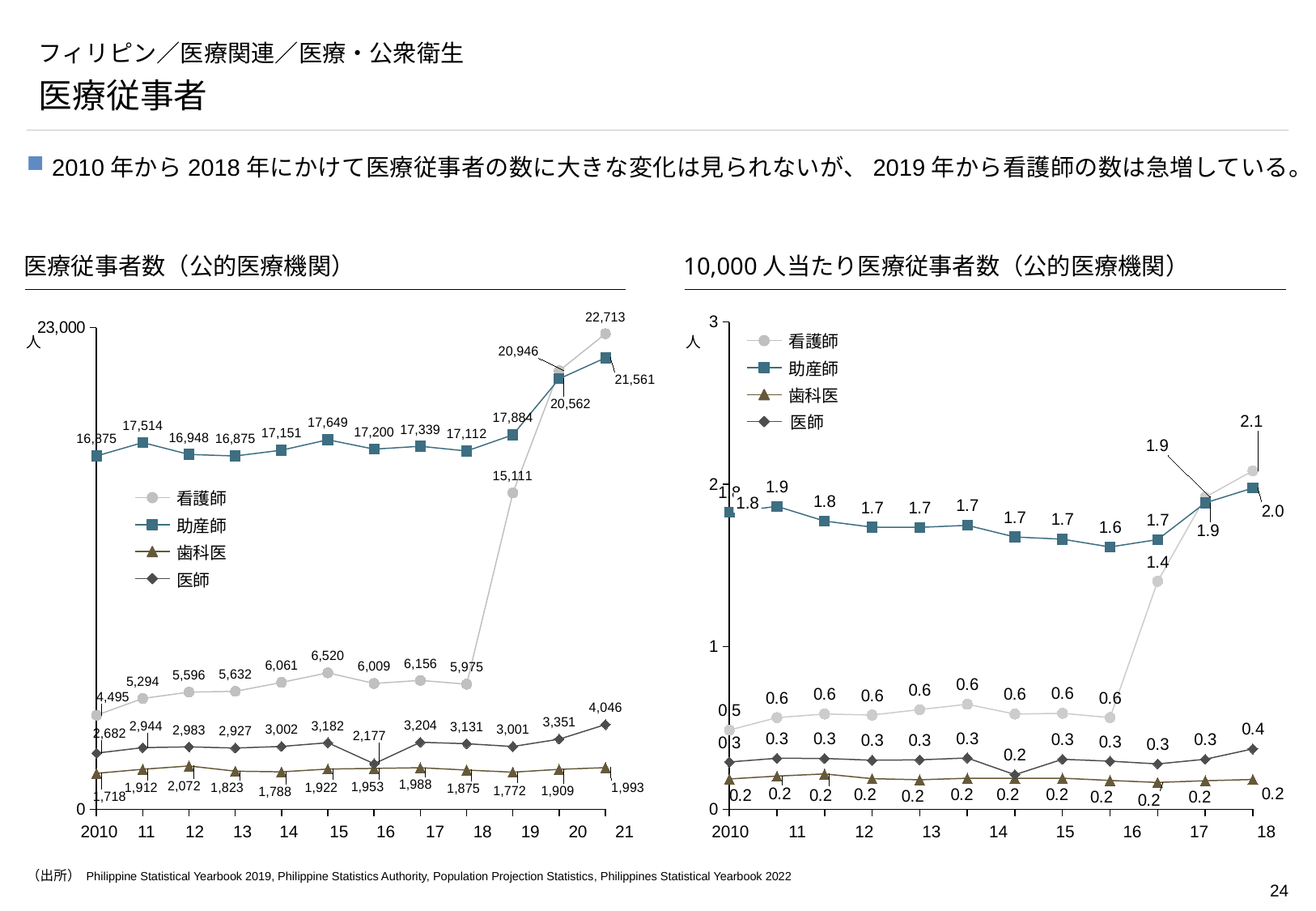
In the chart titled 医療従事者数（公的医療機関）, how many series does the legend list? 4 In the chart titled 医療従事者数（公的医療機関）, in which year does 看護師 reach its highest value? 2021 What kind of chart is the chart titled 10,000人当たり医療従事者数（公的医療機関）? line chart In the chart titled 医療従事者数（公的医療機関）, what is the value for 歯科医 in 2012? 2,072 In the chart titled 医療従事者数（公的医療機関）, what is the value for 助産師 in 2010? 16,875 In the chart titled 医療従事者数（公的医療機関）, what is the value for 医師 in 2021? 4,046 In the chart titled 医療従事者数（公的医療機関）, which is larger in 2021: 看護師 or 助産師? 看護師 In the chart titled 医療従事者数（公的医療機関）, what is the value for 医師 in 2016? 2,177 In the chart titled 10,000人当たり医療従事者数（公的医療機関）, what is the lowest value shown for 助産師? 1.6 In the chart titled 10,000人当たり医療従事者数（公的医療機関）, what is the highest value shown for 看護師? 2.1 In the chart titled 医療従事者数（公的医療機関）, what is the difference between 看護師 in 2019 and 看護師 in 2018? 5,835 In the chart titled 医療従事者数（公的医療機関）, what is the value for 看護師 in 2021? 22,713